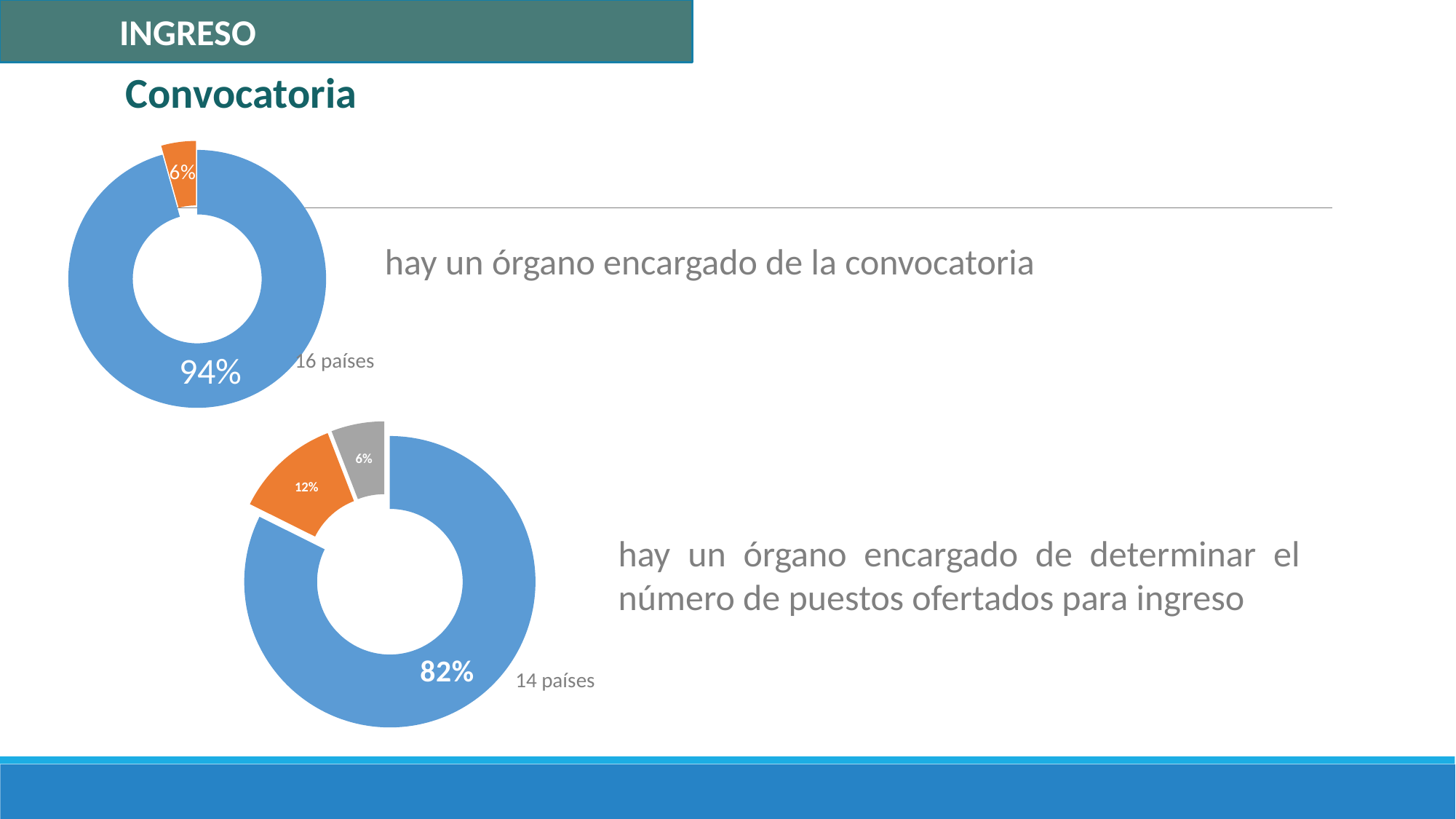
How many countries are noted next to the top chart? 16 países What kind of chart is the top chart on the slide? Doughnut (pie) chart In the top chart, what is the difference between the blue slice and the orange slice? 88% In the bottom chart, which slice is the smallest? The grey slice (6%) In the bottom chart (next to 'hay un órgano encargado de determinar el número de puestos ofertados para ingreso'), what value is shown on the blue slice? 82% In the bottom chart (next to 'hay un órgano encargado de determinar el número de puestos ofertados para ingreso'), what value is shown on the orange slice? 12% How many slices does the top chart have? 2 In the top chart (next to 'hay un órgano encargado de la convocatoria'), what value is shown on the orange slice? 6% How many slices does the bottom chart have? 3 In the top chart (next to 'hay un órgano encargado de la convocatoria'), what value is shown on the blue slice? 94% In the bottom chart (next to 'hay un órgano encargado de determinar el número de puestos ofertados para ingreso'), what value is shown on the grey slice? 6% In the bottom chart, which slice is the largest? The blue slice (82%)